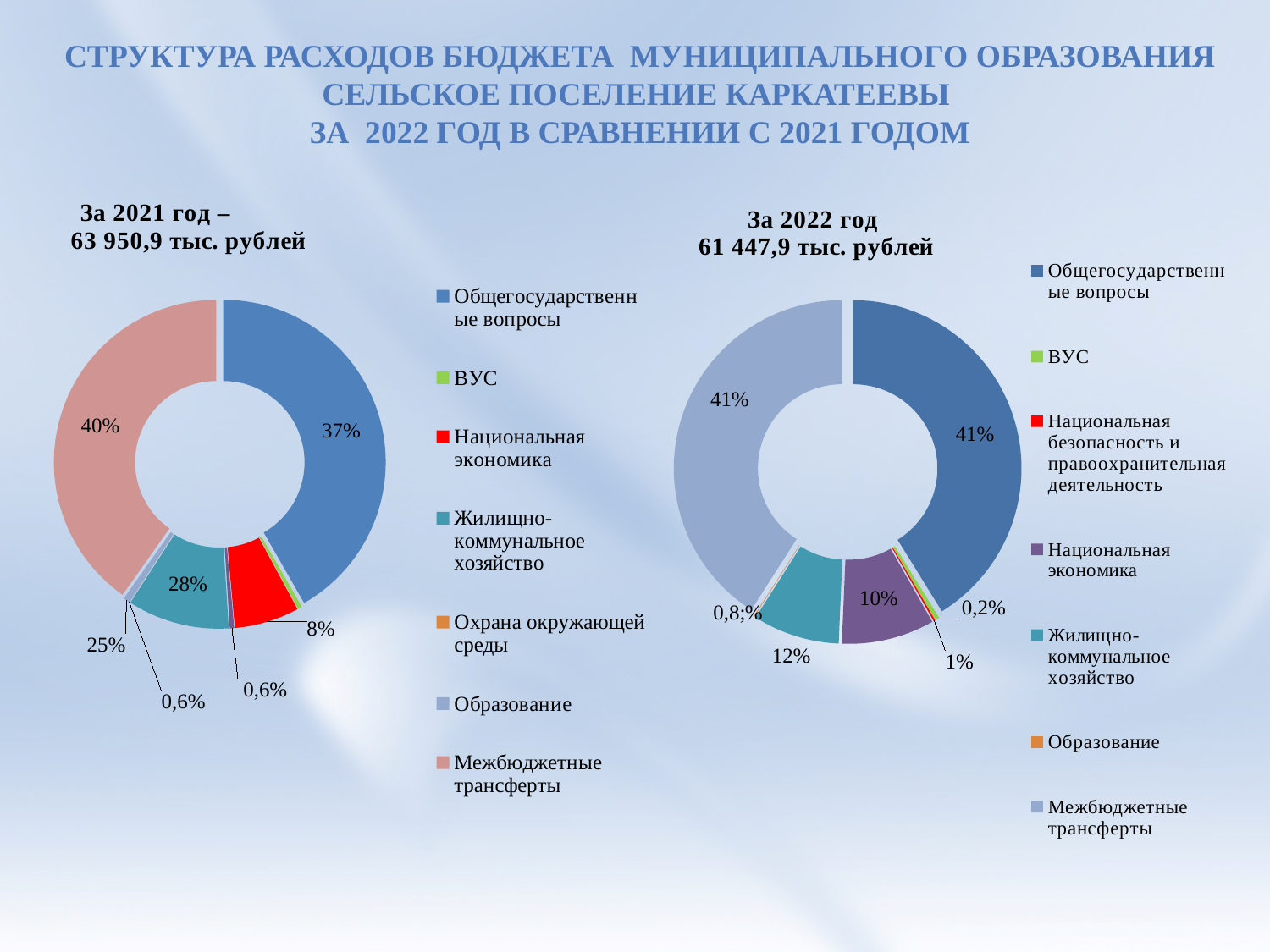
What kind of chart is used for the 2021 data on the left? Doughnut (pie) chart In the 2021 chart (За 2021 год), what share is shown for Межбюджетные трансферты? 40% In the 2022 chart (За 2022 год), what share is shown for Национальная экономика? 10% How many categories does the legend of the 2022 chart (За 2022 год) list? 7 In the 2021 chart (За 2021 год), what share is shown for Жилищно-коммунальное хозяйство? 28% In the 2022 chart (За 2022 год), what share is shown for Жилищно-коммунальное хозяйство? 12% What total expenditure amount is given in the title of the 2022 chart? 61 447,9 тыс. рублей In the 2021 chart (За 2021 год), how many percentage points larger is Межбюджетные трансферты than Общегосударственные вопросы? 3 percentage points In the 2022 chart (За 2022 год), which is larger: Жилищно-коммунальное хозяйство or Национальная экономика? Жилищно-коммунальное хозяйство In the 2021 chart (За 2021 год), which category has the largest share? Межбюджетные трансферты In the 2021 chart (За 2021 год), what share is shown for Национальная экономика? 8% In the 2021 chart (За 2021 год), what share is shown for Общегосударственные вопросы? 37%